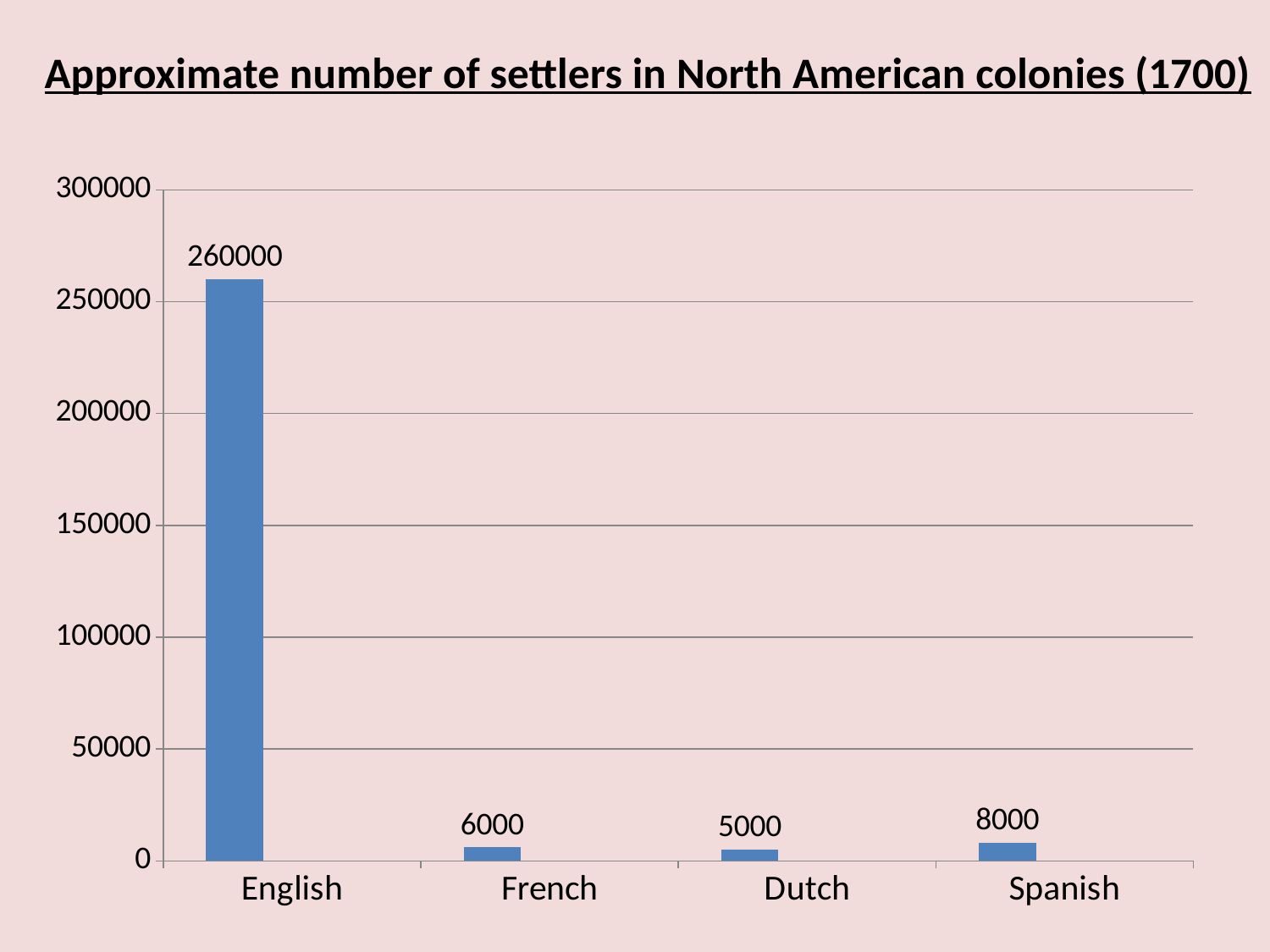
What type of chart is shown on the slide? Bar chart Which colony group has the highest number of settlers? English What is the approximate number of French settlers shown on the chart? 6000 Is the value for English greater or less than 250000? greater Which has more settlers, French or Dutch? French What is the approximate number of Spanish settlers shown on the chart? 8000 How many colony groups are shown on the chart? 4 What is the approximate number of English settlers shown on the chart? 260000 Which colony group has the lowest number of settlers? Dutch What is the difference between the number of Spanish settlers and the number of French settlers? 2000 What is the approximate number of Dutch settlers shown on the chart? 5000 What is the difference between the number of English settlers and the number of Spanish settlers? 252000